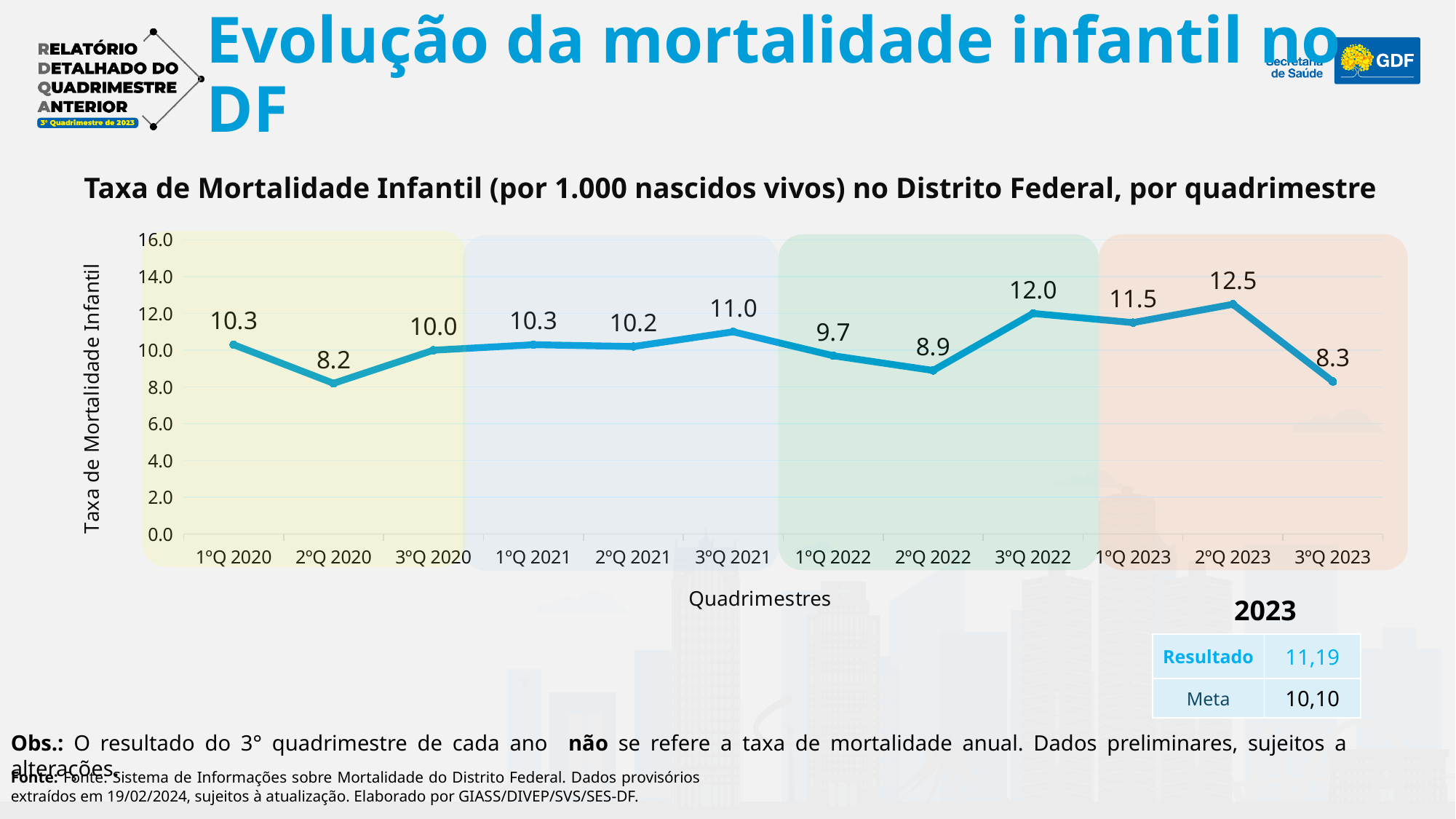
What is the label of the y axis of the chart? Taxa de Mortalidade Infantil Which quadrimestre has the lowest infant mortality rate? 2ºQ 2020 Does the infant mortality rate rise or fall from 2ºQ 2022 to 3ºQ 2022? rise What is the infant mortality rate for 1ºQ 2020? 10.3 Which quadrimestre has the highest infant mortality rate? 2ºQ 2023 How many quadrimestres are plotted on the chart? 12 What is the difference between the rates for 2ºQ 2023 and 3ºQ 2023? 4.2 Is the value for 3ºQ 2022 greater or less than 10.0? greater What kind of chart is shown on the slide? line chart Which is larger, the rate for 3ºQ 2021 or the rate for 1ºQ 2022? 3ºQ 2021 What is the infant mortality rate for 3ºQ 2023? 8.3 What is the infant mortality rate for 2ºQ 2022? 8.9